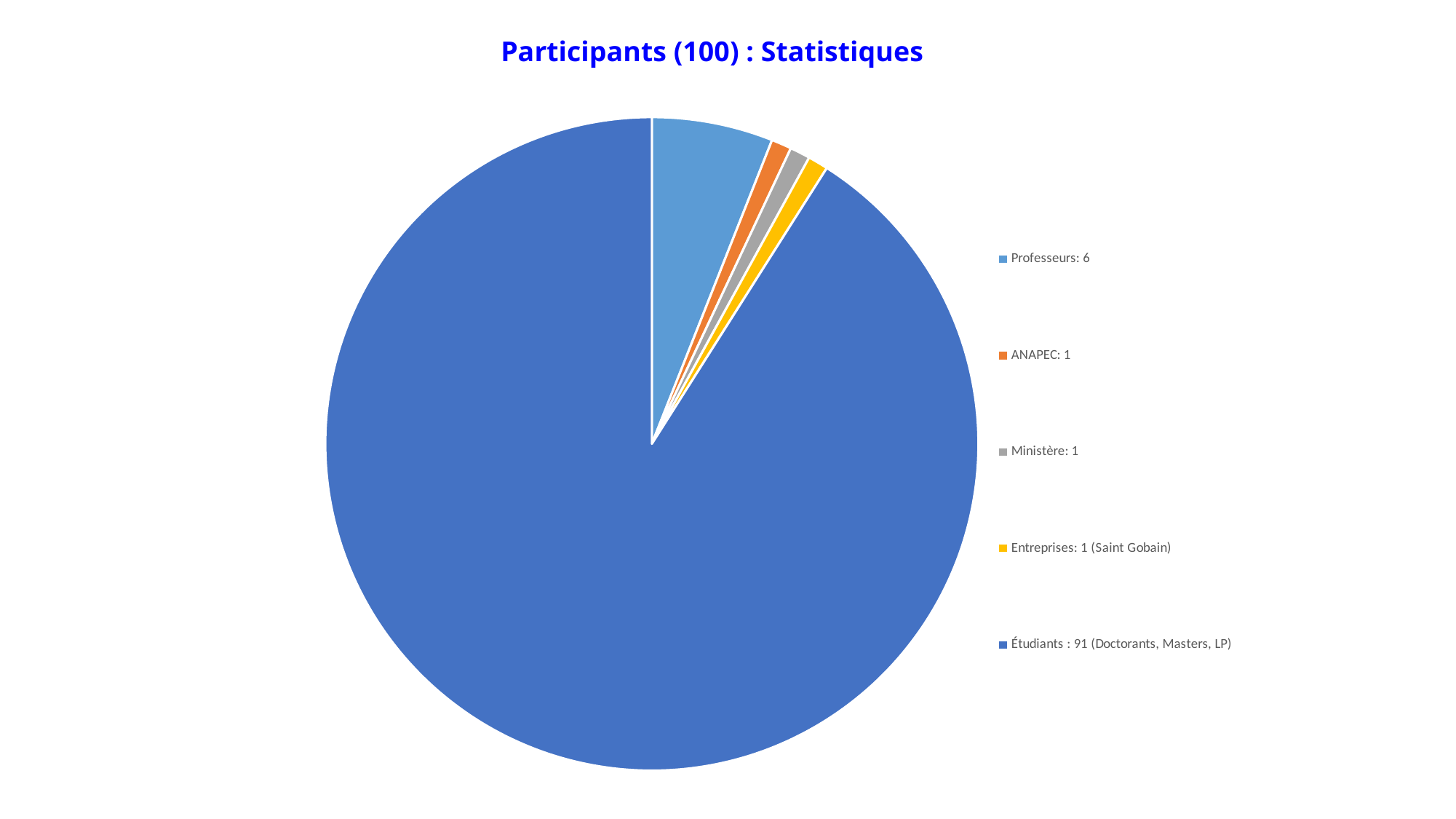
How many participants are Étudiants? 91 Which company is named in the Entreprises legend entry? Saint Gobain Which is larger, the number of Professeurs or the number of Ministère participants? Professeurs What type of chart is shown on the slide? Pie chart How many categories does the pie chart have? 5 How many participants are Professeurs? 6 Which category has the largest slice of the pie? Étudiants What share of the pie do the Professeurs represent? 6% How many participants are from ANAPEC? 1 What is the title of the chart? Participants (100) : Statistiques What is the difference between the number of Étudiants and the number of Professeurs? 85 What share of the pie do the Étudiants represent? 91%